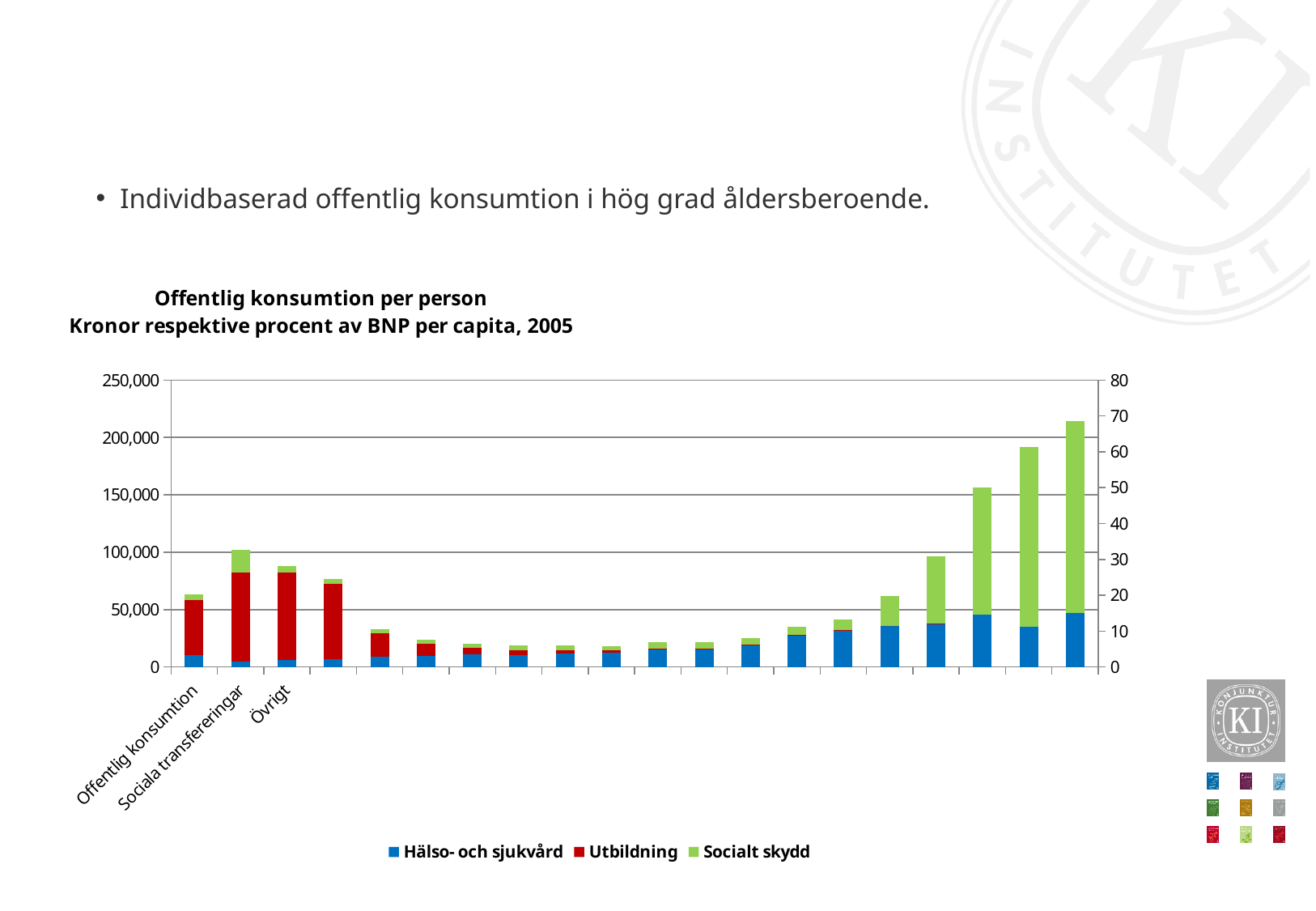
Which has the larger total value, Sociala transfereringar or Övrigt? Sociala transfereringar Is the total value of the rightmost bar greater or less than 200,000? greater Is the total value of the bar for Sociala transfereringar greater or less than 50,000? greater What is the title of the chart? Offentlig konsumtion per person Kronor respektive procent av BNP per capita, 2005 Which has the larger total value, Offentlig konsumtion or Sociala transfereringar? Sociala transfereringar Is the total value of the bar for Övrigt greater or less than 100,000? less What kind of chart is shown on the slide? Stacked bar chart How many bars are plotted in the chart? 20 Which series is shown in green in the legend? Socialt skydd Which bar has the highest total value? The rightmost bar How many series does the legend list? 3